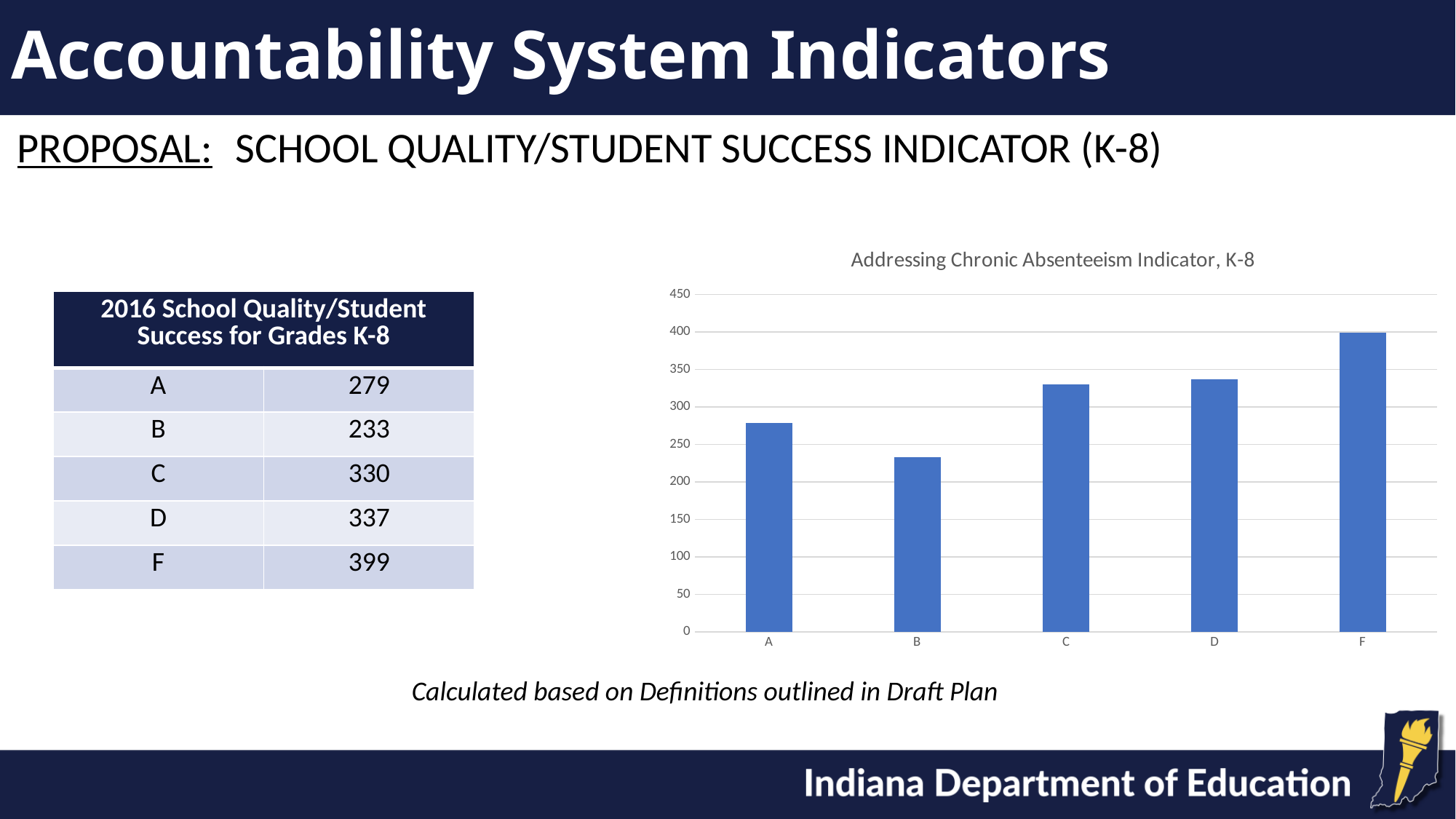
What type of chart is shown on the slide? bar chart Which is larger, the value for A or the value for C? C Which category has the lowest bar in the chart? B How many categories are shown on the x axis of the chart? 5 Is the value for A greater or less than 300? less Which category has the highest bar in the chart? F What is the value for F in the chart, as printed in the table on the slide? 399 What is the title of the chart? Addressing Chronic Absenteeism Indicator, K-8 Using the values printed in the table, what is the difference between F and B? 166 Is the value for F greater or less than 350? greater What is the value for A in the chart, as printed in the table on the slide? 279 Is the value for B greater or less than 250? less